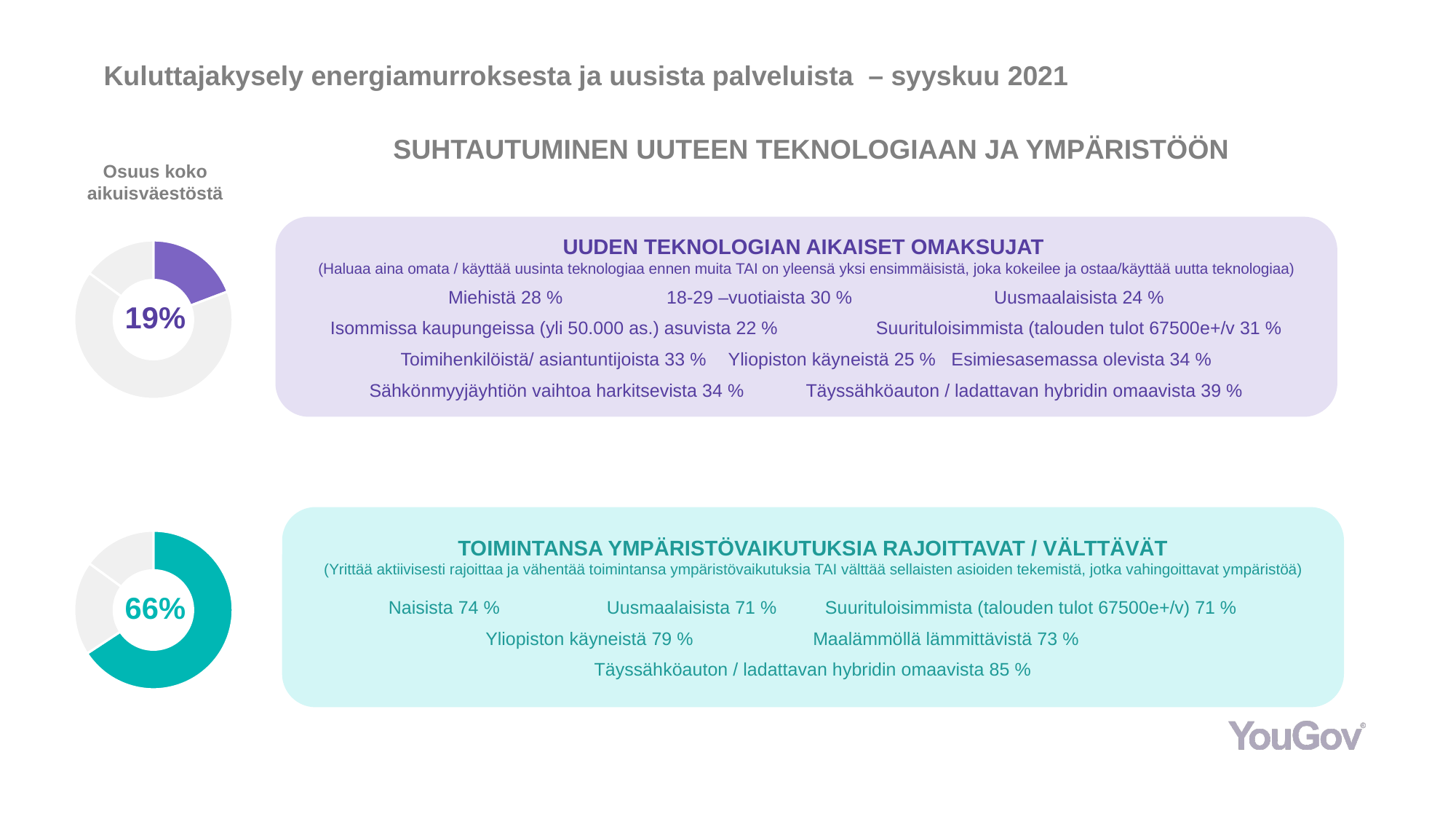
Is the highlighted share in the bottom donut chart greater or less than 50%? greater Is the highlighted share in the top donut chart greater or less than 50%? less What label appears above the donut charts describing what they measure? Osuus koko aikuisväestöstä In the bottom donut chart, what share of the ring is not highlighted (the grey remainder)? 34% What percentage is shown in the centre of the bottom donut chart? 66% In the top donut chart, what share of the ring is not highlighted (the grey remainder)? 81% Which group does the 66% donut chart refer to, according to the heading of the panel next to it? Toimintansa ympäristövaikutuksia rajoittavat / välttävät What is the difference in percentage points between the bottom donut chart value (66%) and the top donut chart value (19%)? 47 percentage points What colour is the highlighted segment of the top donut chart? Purple Which donut chart shows the larger share, the top one or the bottom one? The bottom one (66%) What kind of chart is used to show the 19% and 66% shares on the left of the slide? Donut (pie) chart What percentage is shown in the centre of the top donut chart? 19%